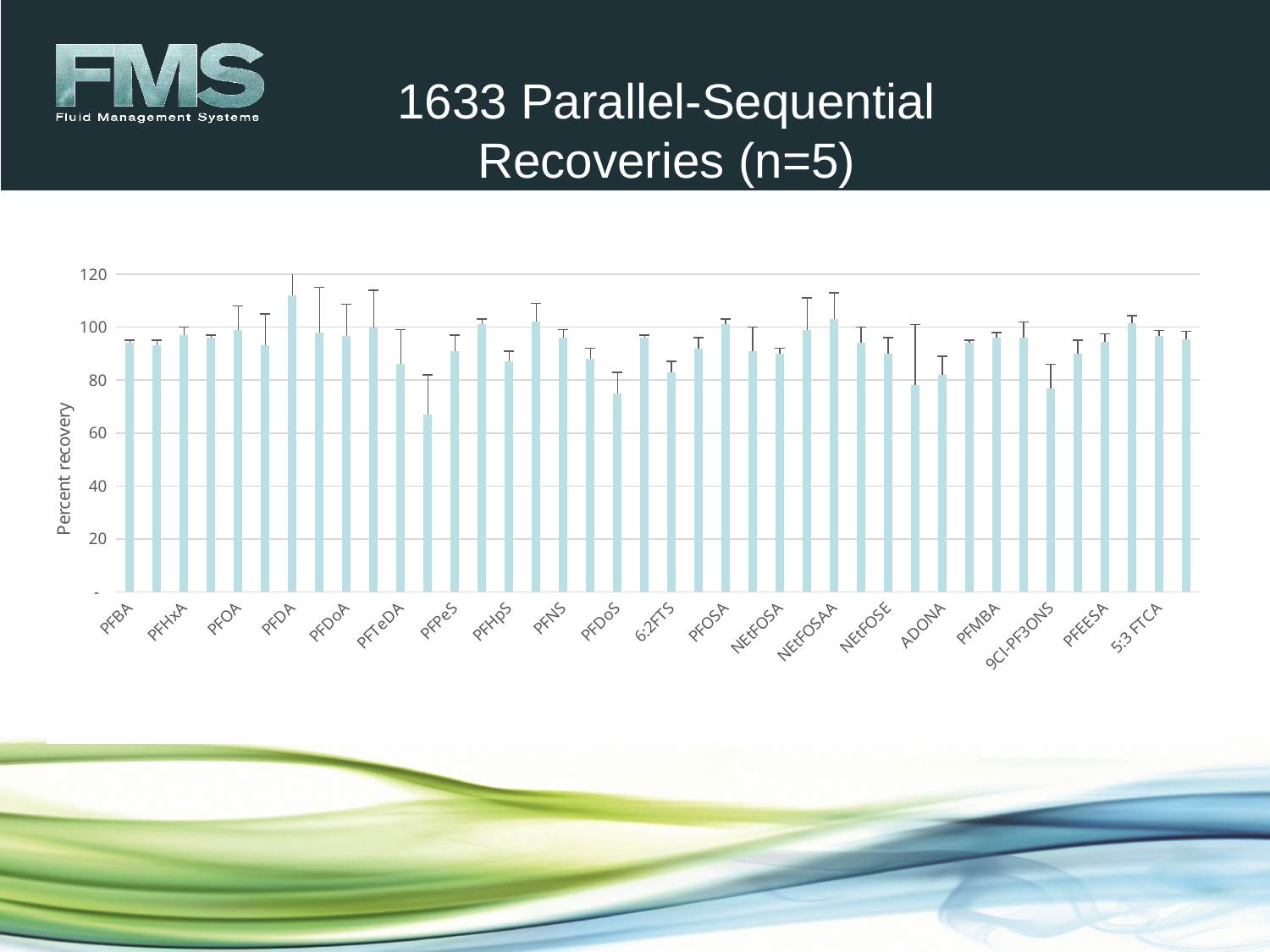
What is the title of the chart on the slide? 1633 Parallel-Sequential Recoveries (n=5) What kind of chart is shown on the slide? Bar chart Is the percent recovery for PFDoS greater or less than 80? less Is the percent recovery for PFTeDA greater or less than 100? less Which labelled compound has the highest percent recovery? PFDA Which has the higher percent recovery, PFDA or PFDoS? PFDA How many compound labels are shown on the x axis? 20 Is the percent recovery for 9Cl-PF3ONS greater or less than 80? less Which has the higher percent recovery, PFBA or PFDoS? PFBA What is the label of the vertical axis? Percent recovery